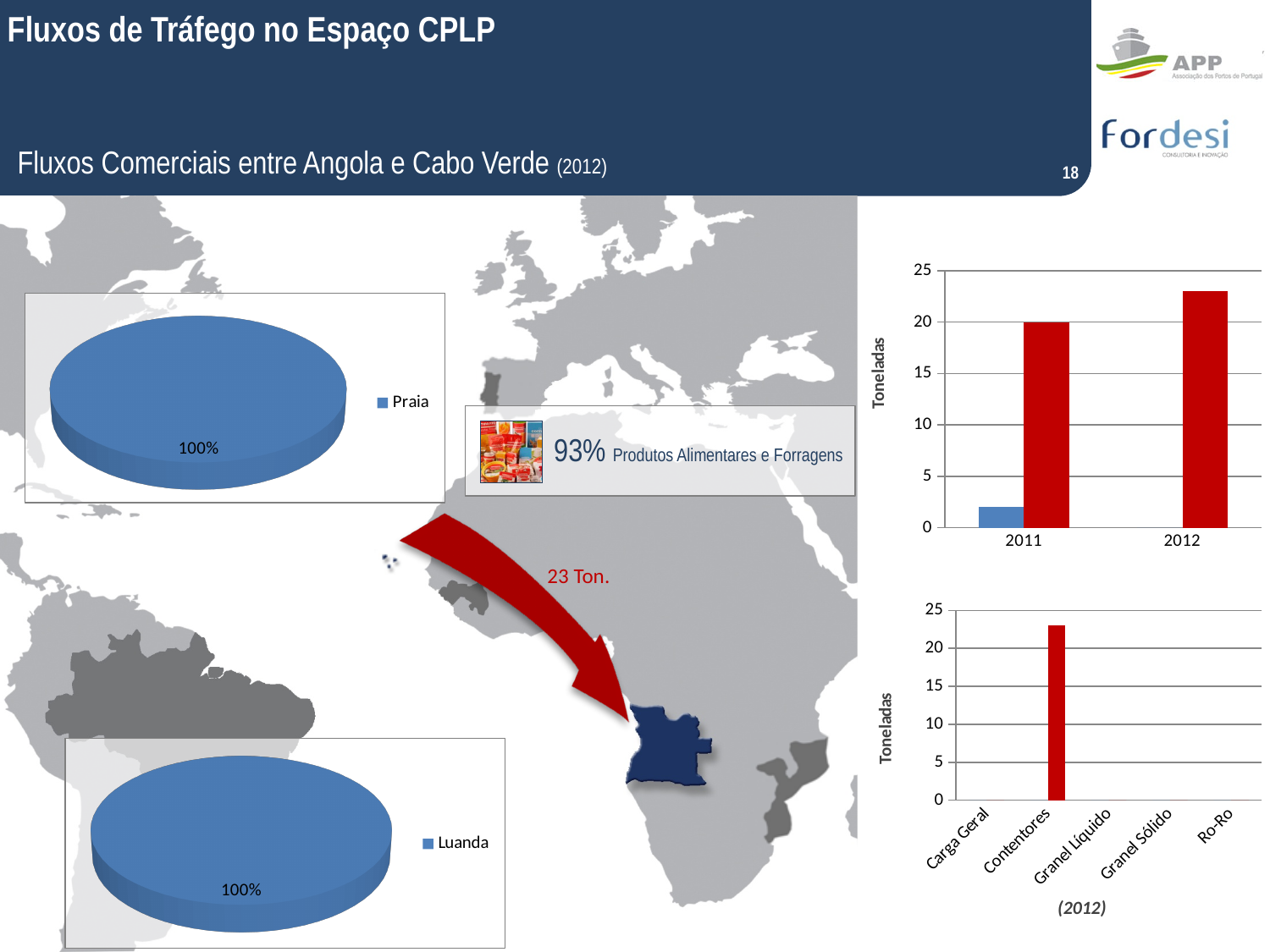
On the bottom-right chart with cargo types on the x axis, which category has the highest value? Contentores On the bottom-right chart with cargo types on the x axis, how many categories are shown? 5 On the bottom-right chart with cargo types on the x axis, is the value for Contentores greater or less than 20? greater On the top-right chart with years on the x axis, what kind of chart is it? bar chart On the top-right chart with years on the x axis, how many years are shown? 2 What kind of chart is the top-left chart with the Praia legend? pie chart On the top-right chart with years on the x axis, which year has the taller red bar, 2011 or 2012? 2012 On the top-right chart with years on the x axis, is the value of the blue bar for 2011 greater or less than 5? less On the top-right chart with years on the x axis, is the value of the red bar for 2012 greater or less than 20? greater On the top-right chart with years on the x axis, what is the label of the vertical axis? Toneladas On the top-left pie chart, what share does Praia have? 100% On the bottom-left pie chart, what share does Luanda have? 100%